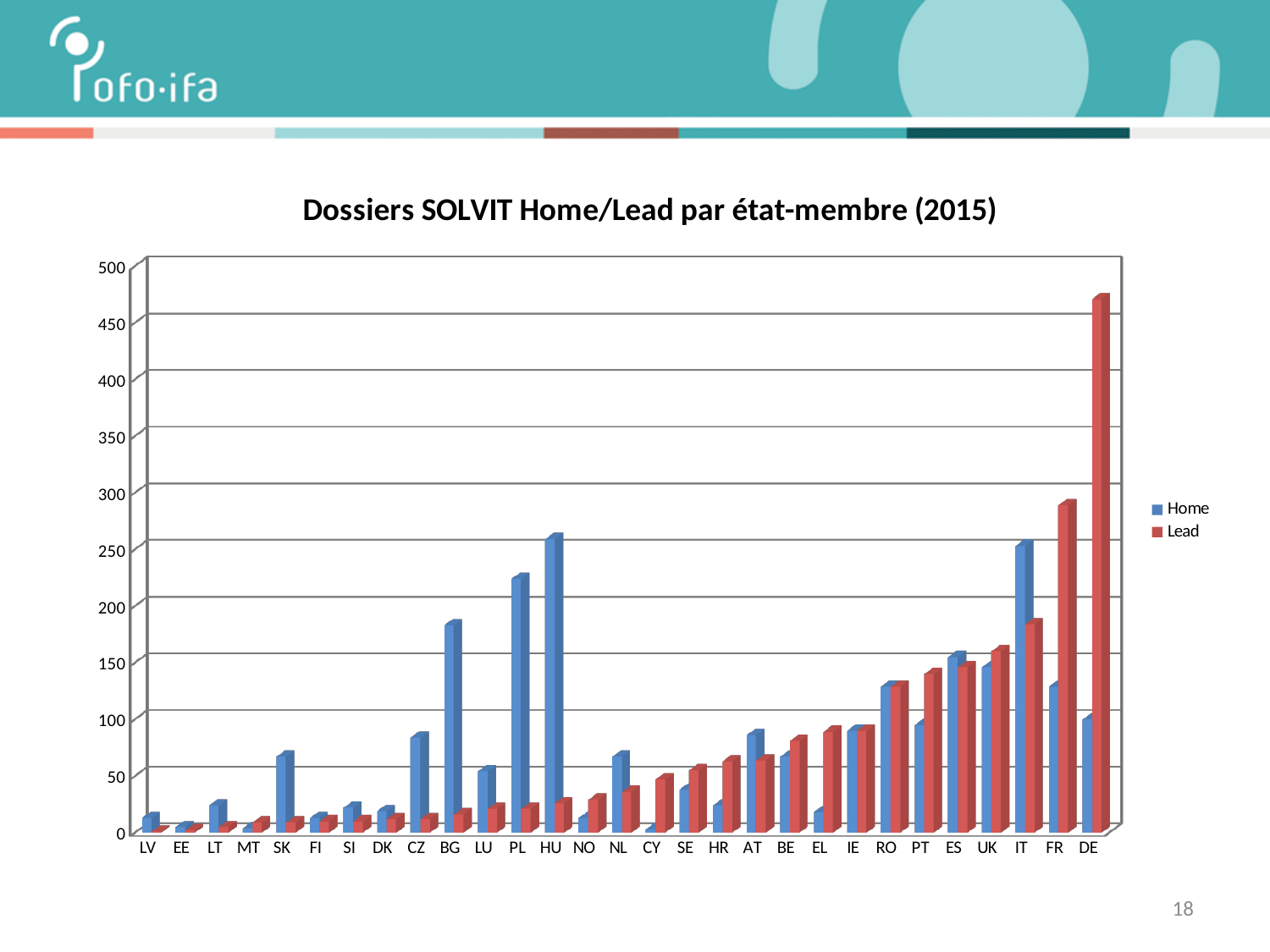
For HU, which is larger: the Home value or the Lead value? Home How many series does the legend list? 2 Which member state has the highest Lead value? DE What kind of chart is shown on the slide? bar chart Is the Home value for PL greater or less than 200? greater Is the Lead value for FR greater or less than 250? greater For DE, which is larger: the Home value or the Lead value? Lead Which member state has the highest Home value? HU What is the title of the chart? Dossiers SOLVIT Home/Lead par état-membre (2015) Is the Home value for BG greater or less than 150? greater How many member states (categories) are shown on the x axis? 29